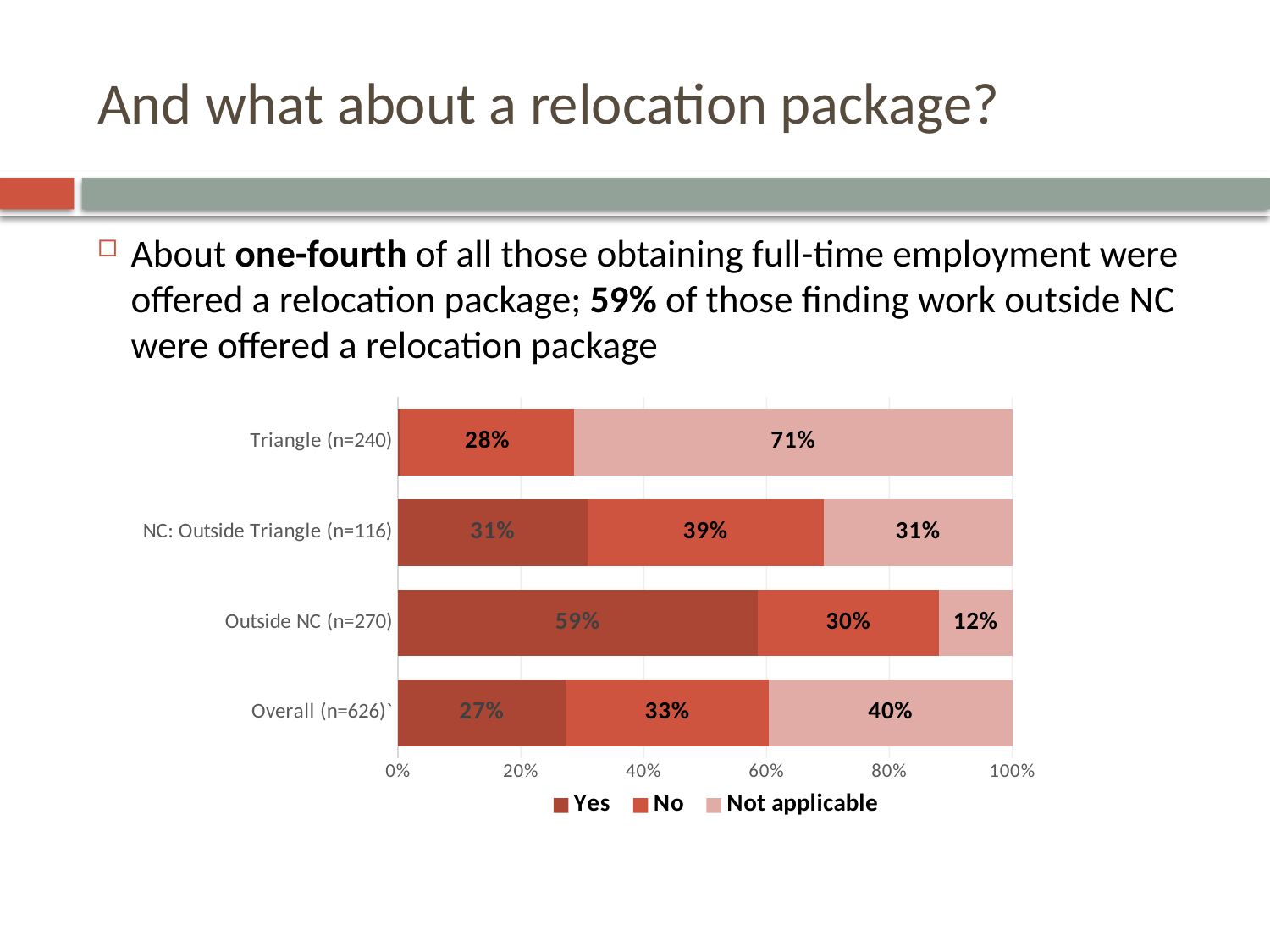
Which category has the highest Not applicable value? Triangle (n=240) How many categories are shown on the chart? 4 What is the Not applicable value for Triangle (n=240)? 71% How many series does the legend list? 3 What is the No value for Overall (n=626)? 33% What is the difference between the Yes value for Outside NC (n=270) and the Yes value for Overall (n=626)? 32% What kind of chart is shown on the slide? Stacked bar chart What percentage of the Outside NC (n=270) group answered Yes? 59% What is the Yes value for NC: Outside Triangle (n=116)? 31% Which category has the highest Yes value? Outside NC (n=270) What is the Not applicable value for Outside NC (n=270)? 12% For NC: Outside Triangle (n=116), which is larger, the No value or the Not applicable value? No